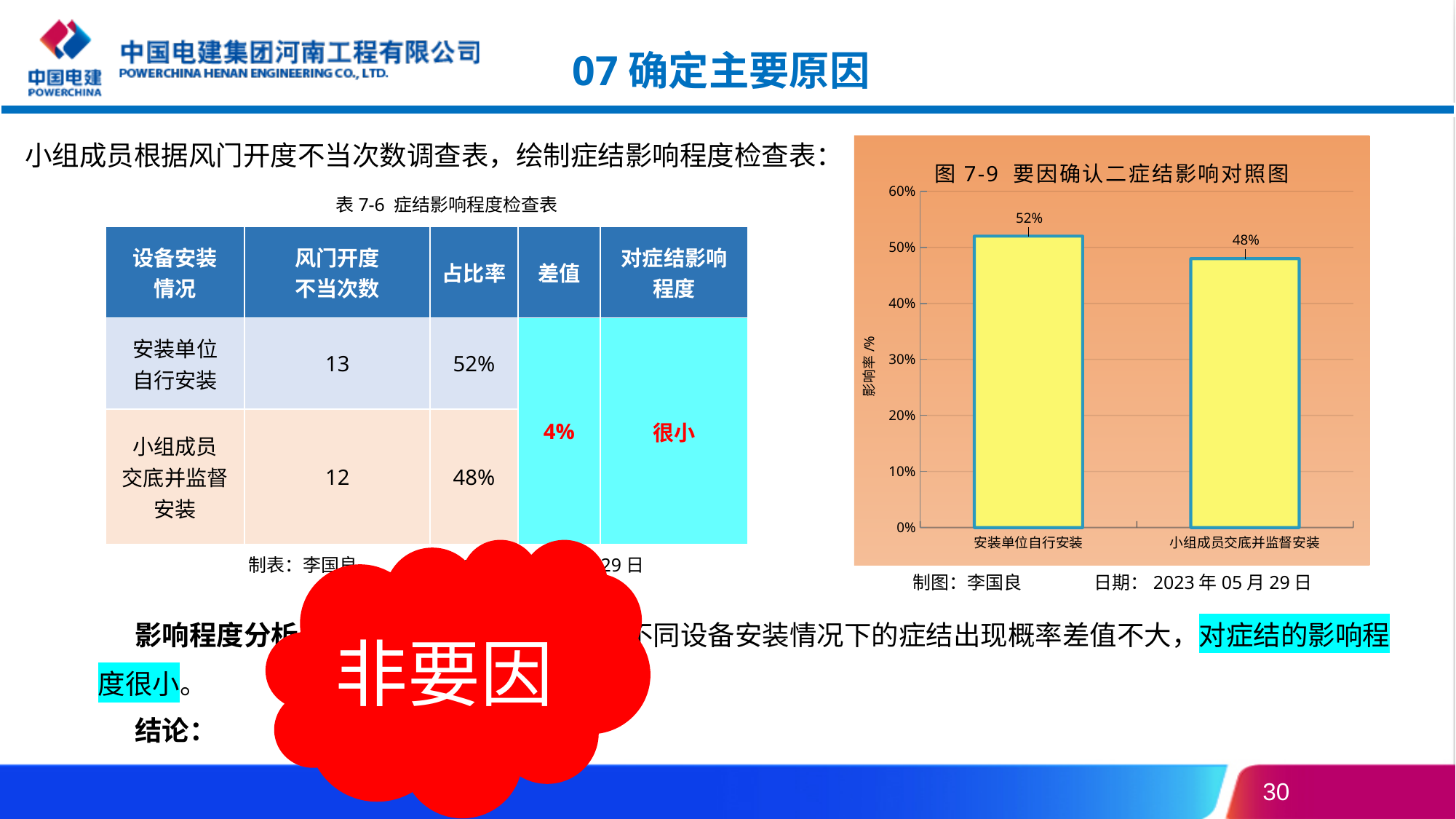
What is the difference between the values for 安装单位自行安装 and 小组成员交底并监督安装? 4% What is the value for 小组成员交底并监督安装 in the chart? 48% What is the label of the vertical axis of the chart? 影响率 /% Is the value for 安装单位自行安装 greater or less than 60%? less What kind of chart is shown on the slide? bar chart Is the value for 小组成员交底并监督安装 greater or less than 40%? greater Which category has the lowest value in the chart? 小组成员交底并监督安装 What is the value for 安装单位自行安装 in the chart? 52% Which is larger: the value for 安装单位自行安装 or for 小组成员交底并监督安装? 安装单位自行安装 Which category has the highest value in the chart? 安装单位自行安装 How many categories are shown in the chart? 2 What is the title of the chart? 图 7-9 要因确认二症结影响对照图